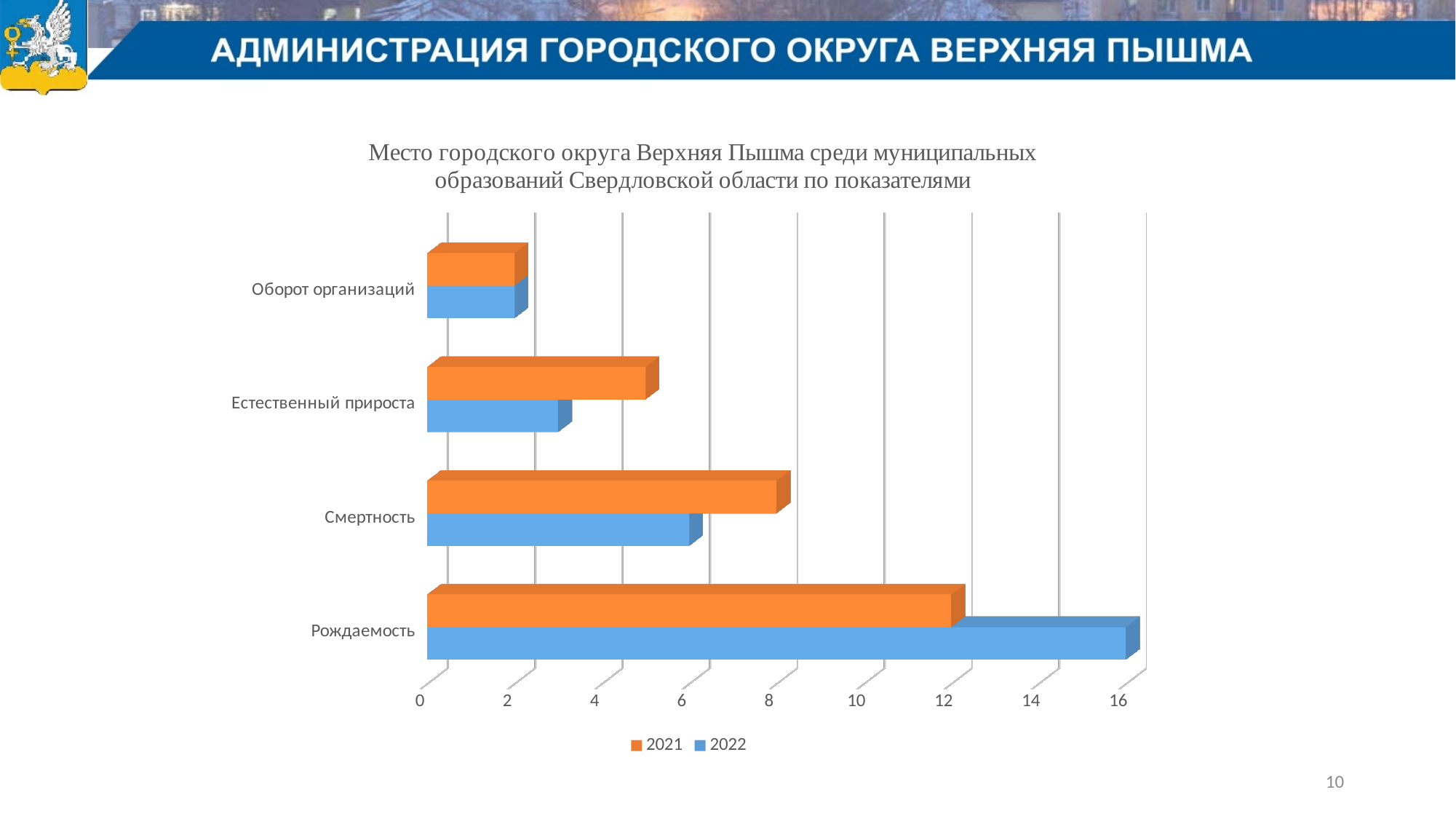
For Естественный прироста, which year has the larger value, 2021 or 2022? 2021 What kind of chart is shown on the slide? bar chart How many series does the legend list? 2 For Рождаемость, which year has the larger value, 2021 or 2022? 2022 Is the 2022 value for Рождаемость greater or less than 14? greater Which series is shown in blue in the legend? 2022 Which category has the lowest value for 2022? Оборот организаций Is the 2022 value for Смертность greater or less than 8? less Is the 2021 value for Смертность greater or less than 6? greater Which category has the highest value for 2021? Рождаемость Which category has the highest value for 2022? Рождаемость How many categories are shown on the chart? 4